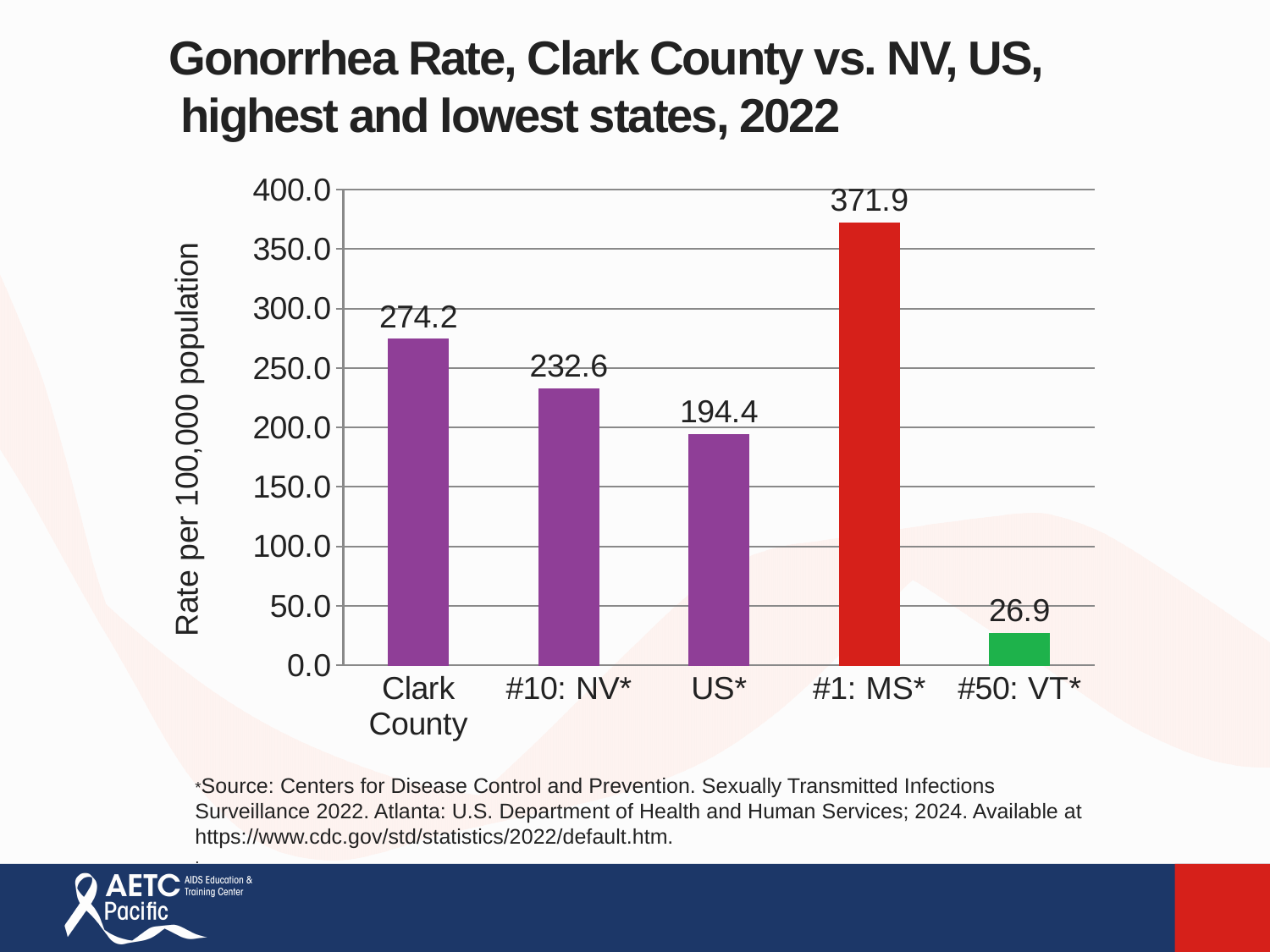
What kind of chart is shown on the slide? Bar chart What is the gonorrhea rate for Clark County? 274.2 What is the difference between the gonorrhea rate for Clark County and the rate for US*? 79.8 How many categories are shown on the x axis of the chart? 5 What is the difference between the gonorrhea rate for #1: MS* and the rate for #50: VT*? 345.0 What is the gonorrhea rate for US*? 194.4 What is the label of the vertical axis of the chart? Rate per 100,000 population What is the gonorrhea rate for #10: NV*? 232.6 Which category has the lowest gonorrhea rate? #50: VT* Which has a higher gonorrhea rate, Clark County or #10: NV*? Clark County Which category has the highest gonorrhea rate? #1: MS* What is the gonorrhea rate for #50: VT*? 26.9